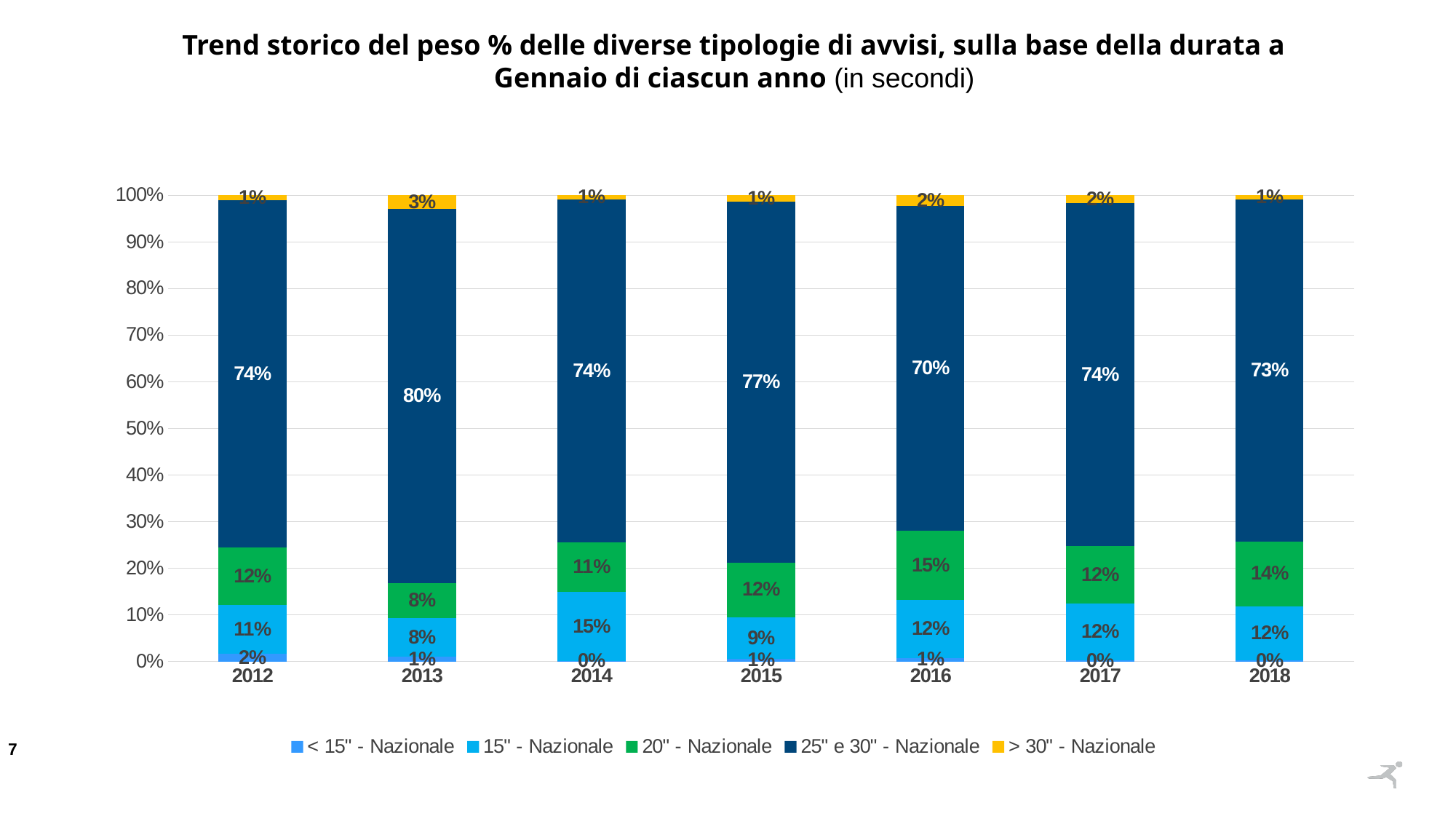
In which year is the 25'' e 30'' - Nazionale share the highest? 2013 How many series does the legend list? 5 Does the 20'' - Nazionale share rise or fall from 2013 to 2016? Rise What kind of chart is shown on the slide? Stacked bar chart What is the difference between the 25'' e 30'' - Nazionale share in 2013 and in 2016? 10 percentage points What is the value for the 25'' e 30'' - Nazionale series in 2013? 80% Which series is shown in yellow in the legend? > 30'' - Nazionale What is the value for the 15'' - Nazionale series in 2014? 15% Which is larger: the 20'' - Nazionale share in 2016 or in 2013? 2016 In which year is the 25'' e 30'' - Nazionale share the lowest? 2016 How many years are shown on the x axis of the chart? 7 What is the value for the > 30'' - Nazionale series in 2013? 3%